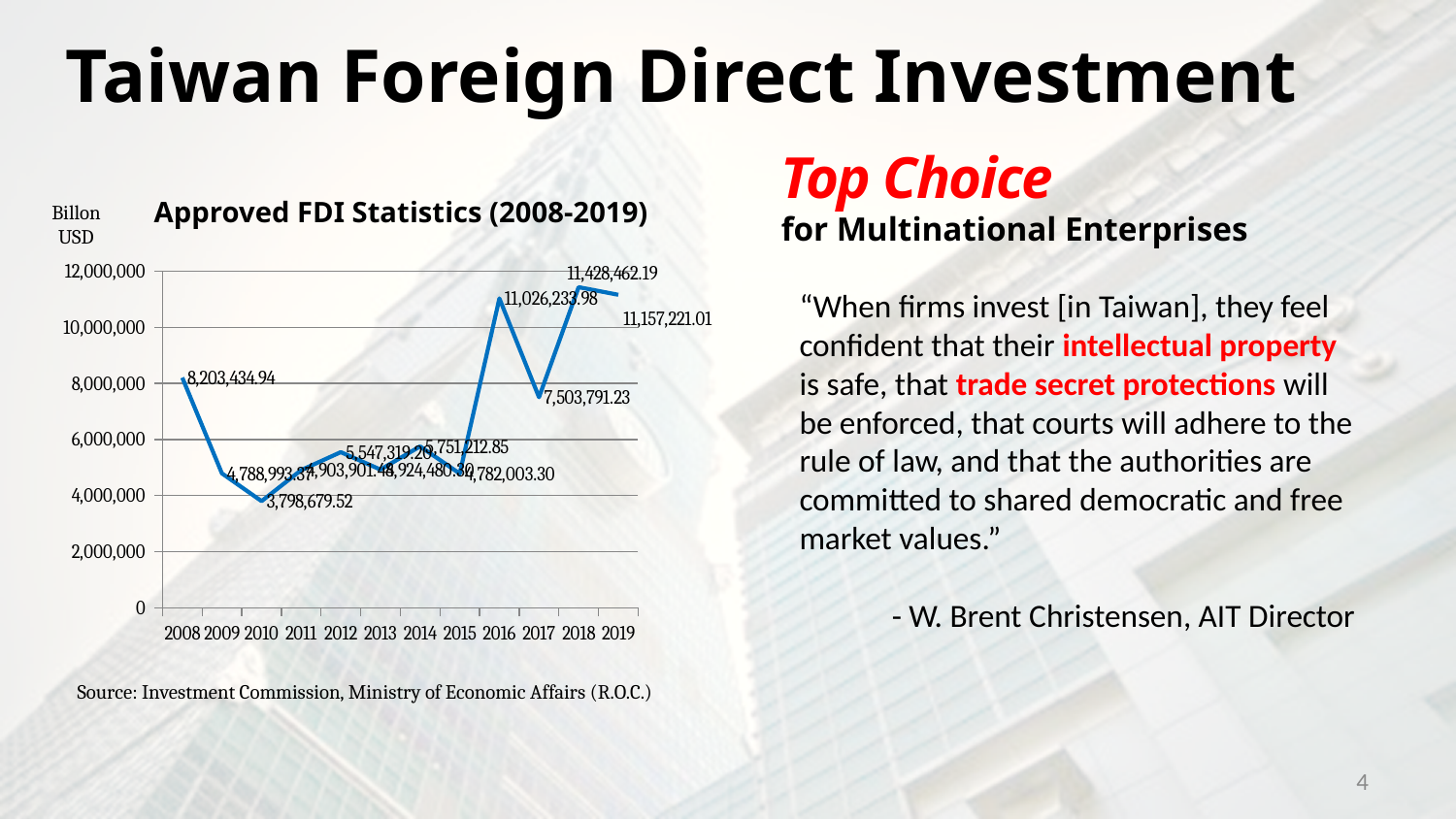
What kind of chart is the Approved FDI Statistics (2008-2019) chart? line chart Which year has the highest approved FDI value? 2018 Is the approved FDI value for 2009 greater or less than 6,000,000? less Does the approved FDI value rise or fall from 2016 to 2017? fall Which year has the lowest approved FDI value? 2010 What is the approved FDI value for 2008? 8,203,434.94 Which year has the larger approved FDI value, 2016 or 2019? 2019 What is the approved FDI value for 2017? 7,503,791.23 What is the difference between the approved FDI values for 2018 and 2017? 3,924,670.96 What is the approved FDI value for 2010? 3,798,679.52 How many years are plotted on the x axis of the Approved FDI Statistics chart? 12 What is the approved FDI value for 2018? 11,428,462.19